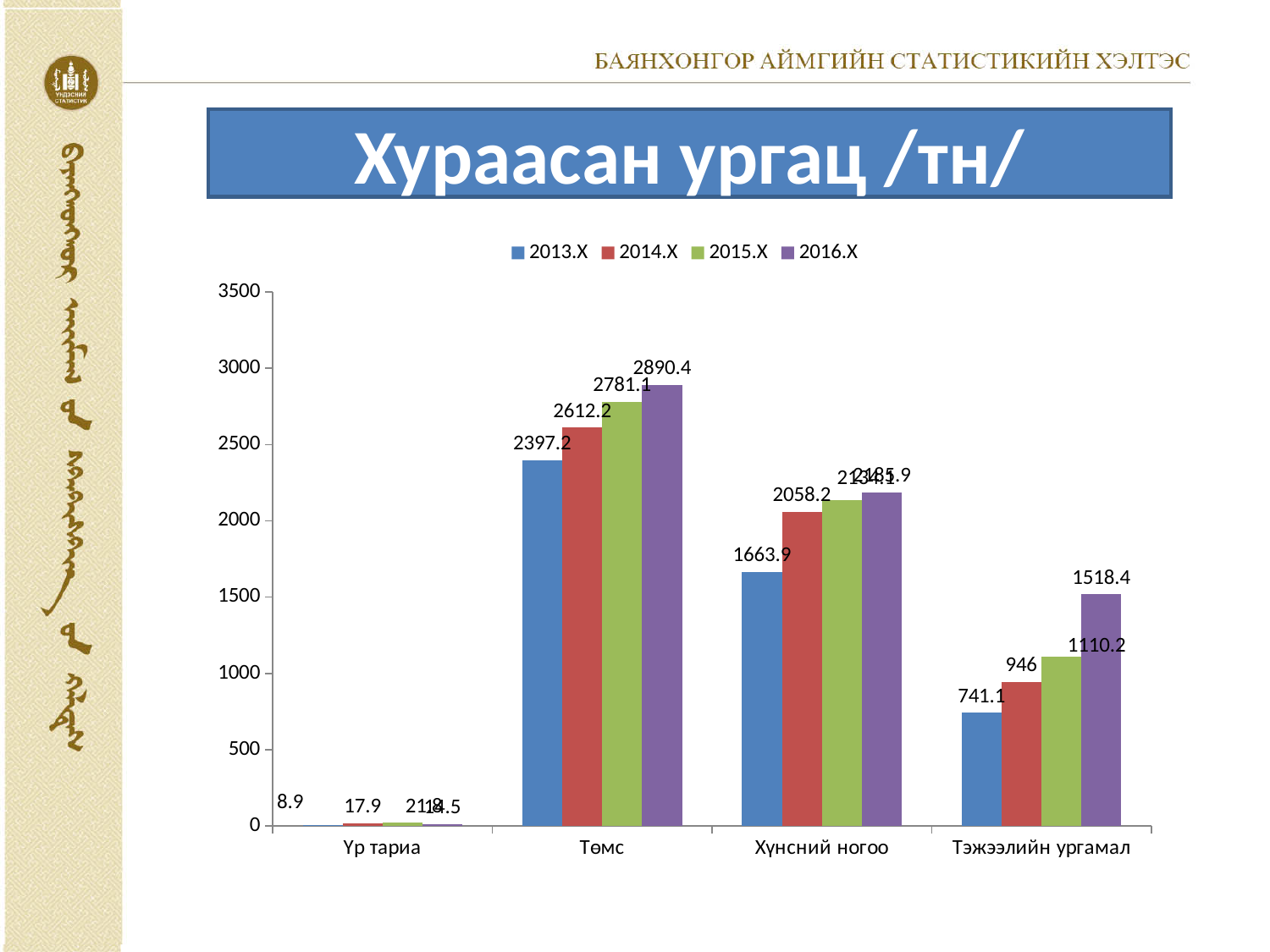
Which is larger for Тэжээлийн ургамал: the 2015.X value or the 2016.X value? 2016.X How many categories are shown on the x axis? 4 Which category has the highest value in 2016.X? Төмс What is the value for Хүнсний ногоо in 2014.X? 2058.2 What is the value for Төмс in 2016.X? 2890.4 Is the value for Хүнсний ногоо in 2016.X greater or less than 2000? greater Which category has the lowest value in 2013.X? Үр тариа What type of chart is shown on the slide? bar chart Do the values for Төмс rise or fall from 2013.X to 2016.X? rise What is the value for Тэжээлийн ургамал in 2013.X? 741.1 What is the difference between the 2016.X and 2013.X values for Төмс? 493.2 How many series does the legend list? 4